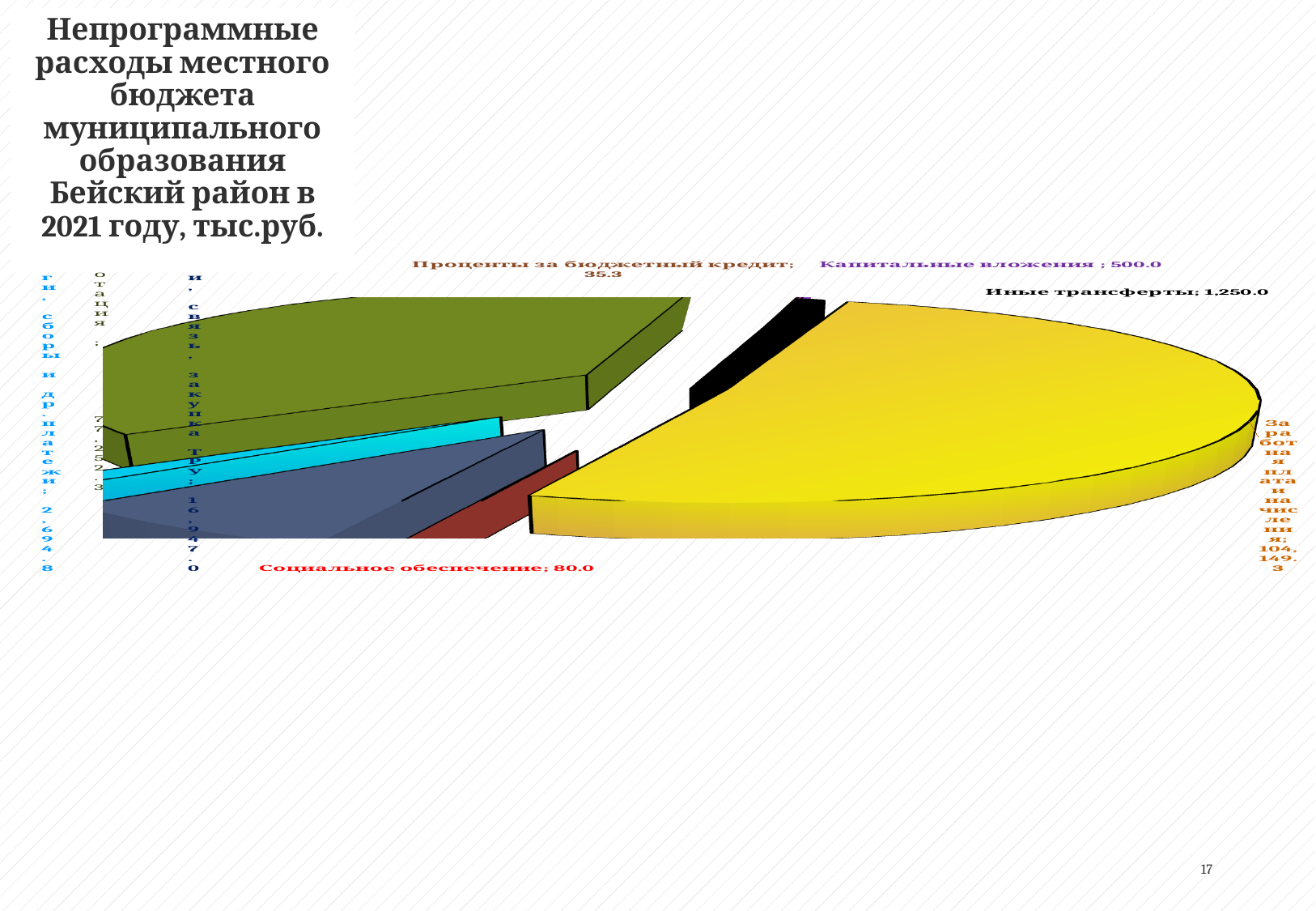
Which is larger, Иные трансферты or Капитальные вложения? Иные трансферты In what units are the values on the chart expressed, according to the slide title? тыс.руб. What is the difference between Иные трансферты and Капитальные вложения? 750.0 What is the value for Иные трансферты? 1,250.0 Which category has the smallest value? Проценты за бюджетный кредит What is the difference between Капитальные вложения and Социальное обеспечение? 420.0 What is the value for Проценты за бюджетный кредит? 35.3 What is the value for Заработная плата и начисления? 104,149.3 What type of chart is shown on the slide? pie chart Which category has the largest slice of the pie? Заработная плата и начисления What is the value for Капитальные вложения? 500.0 What is the value for Социальное обеспечение? 80.0